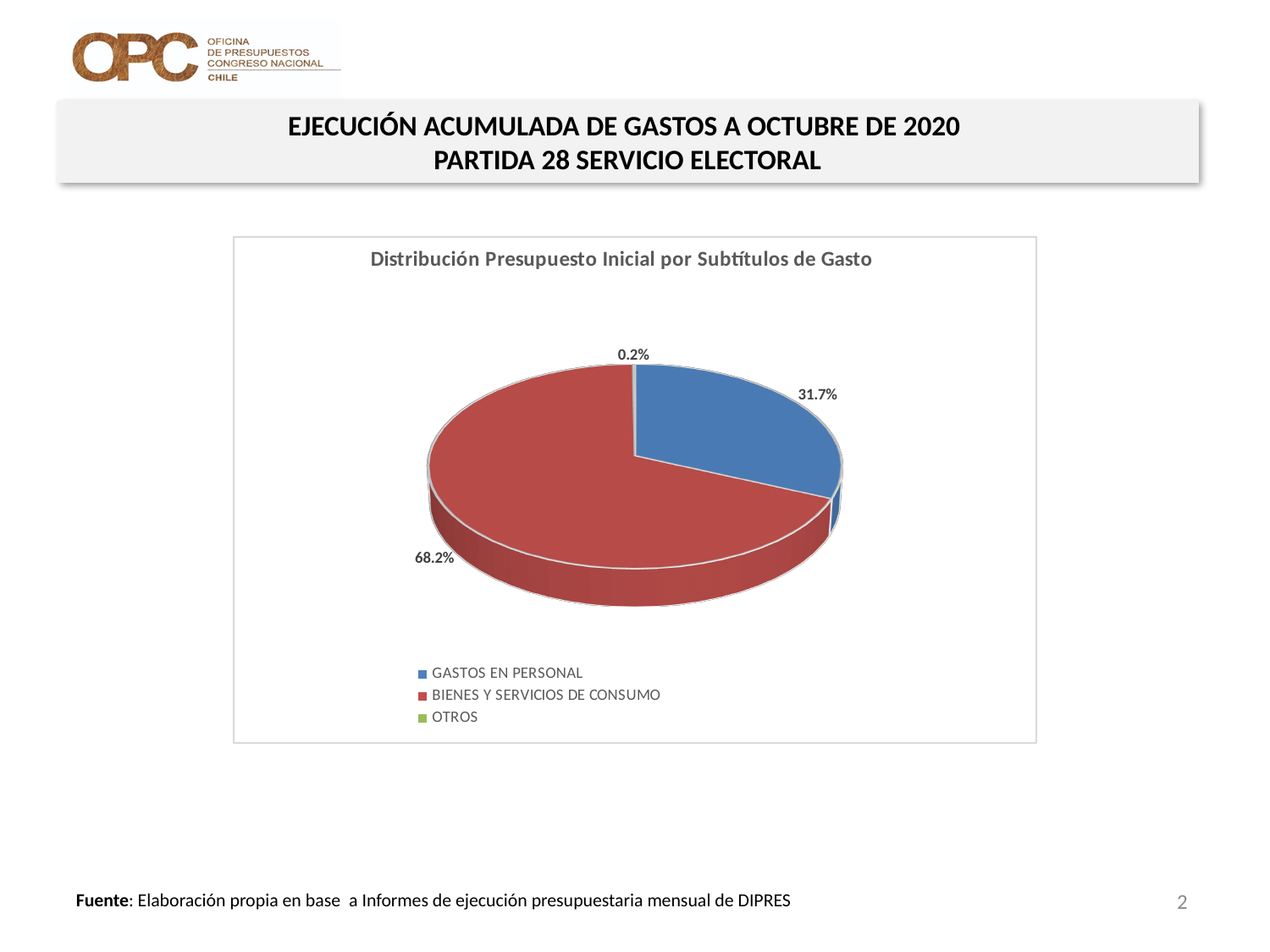
What share of the pie does OTROS represent? 0.2% What share of the pie does BIENES Y SERVICIOS DE CONSUMO represent? 68.2% How many entries does the legend list? 3 What kind of chart is shown on the slide? Pie chart What colour is the slice for GASTOS EN PERSONAL? Blue Which category has the smallest slice of the pie? OTROS How many categories are shown in the pie chart? 3 Which is larger, the share for GASTOS EN PERSONAL or the share for OTROS? GASTOS EN PERSONAL What share of the pie does GASTOS EN PERSONAL represent? 31.7% What is the title of the chart? Distribución Presupuesto Inicial por Subtítulos de Gasto What is the difference in percentage points between BIENES Y SERVICIOS DE CONSUMO and GASTOS EN PERSONAL? 36.5 Which category has the largest slice of the pie? BIENES Y SERVICIOS DE CONSUMO